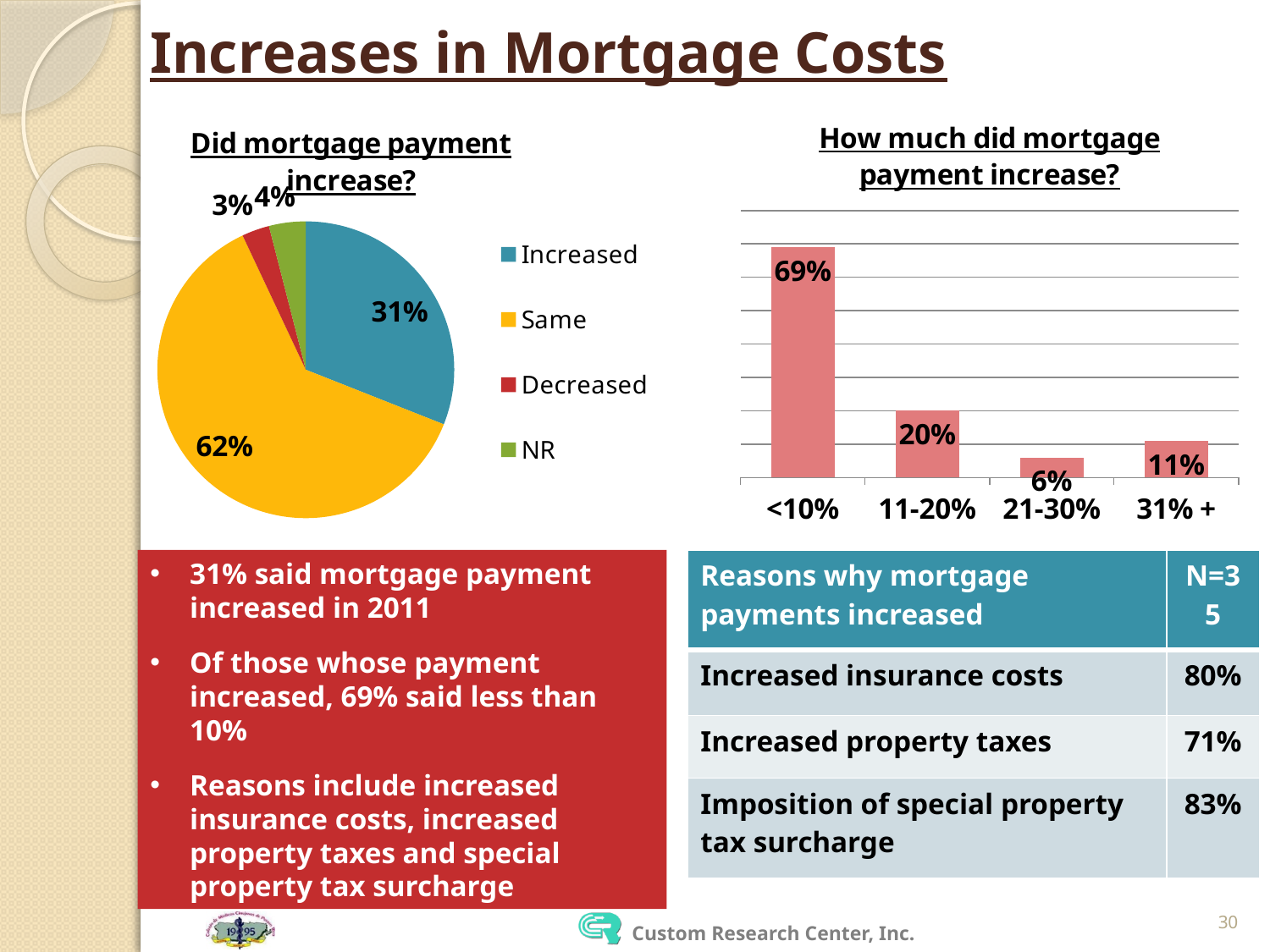
In the 'How much did mortgage payment increase?' chart, which is larger: '11-20%' or '31% +'? 11-20% In the 'Did mortgage payment increase?' chart, what share of respondents said their payment stayed the same? 62% In the 'How much did mortgage payment increase?' chart, what is the value for '21-30%'? 6% In the 'How much did mortgage payment increase?' chart, what is the difference between the '<10%' and '11-20%' values? 49% In the 'How much did mortgage payment increase?' chart, what is the value for '<10%'? 69% In the 'How much did mortgage payment increase?' chart, which category has the lowest value? 21-30% In the 'Did mortgage payment increase?' chart, what percentage said their mortgage payment increased? 31% What type of chart is 'Did mortgage payment increase?' Pie chart In the 'Did mortgage payment increase?' chart, what is the difference between the 'Same' and 'Increased' shares? 31% What type of chart is 'How much did mortgage payment increase?' Bar chart In the 'Did mortgage payment increase?' chart, which category has the smallest slice? Decreased In the 'Did mortgage payment increase?' chart, how many categories does the legend list? 4